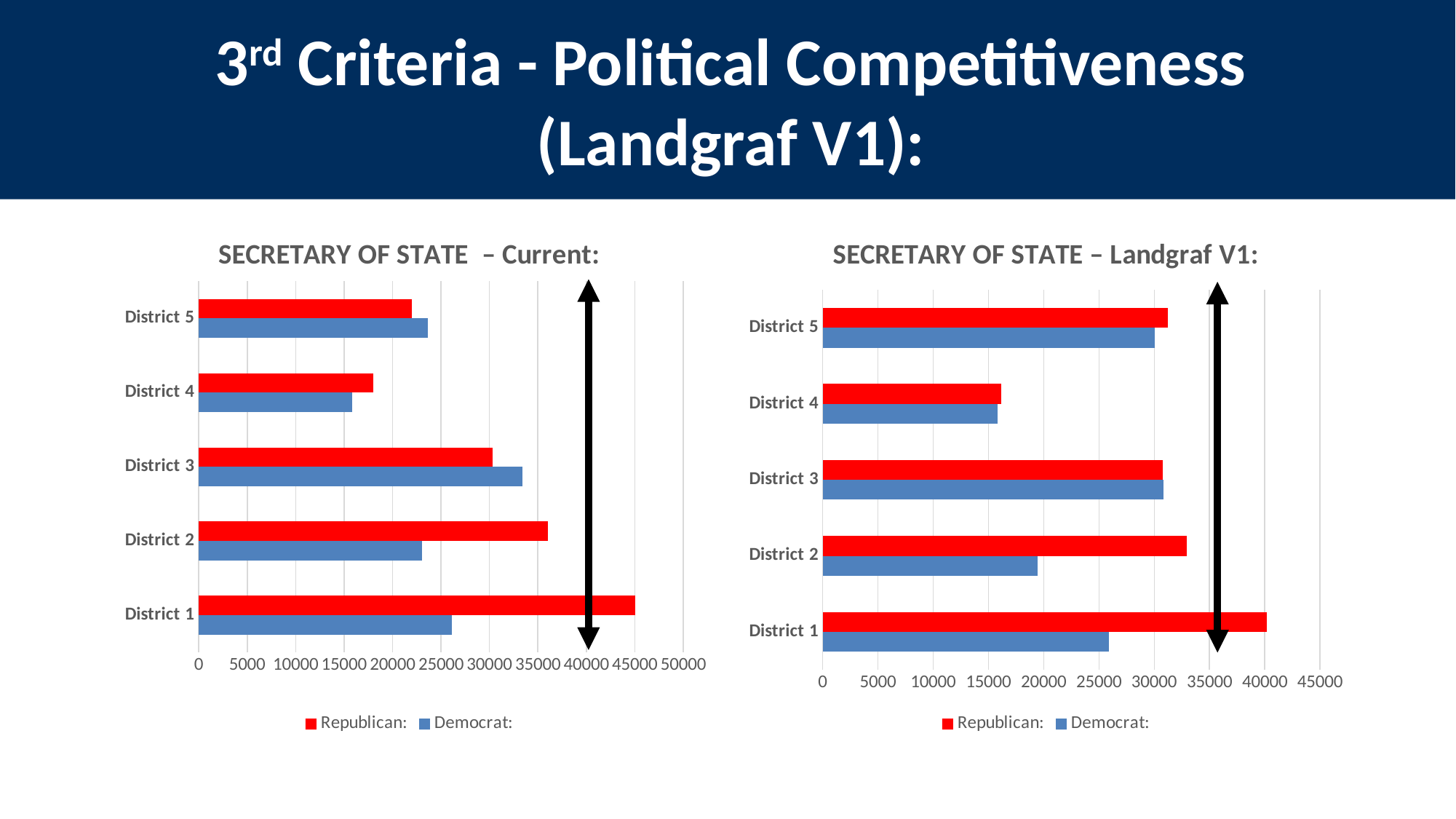
How many series does the legend of the 'SECRETARY OF STATE – Current:' chart list? 2 In the 'SECRETARY OF STATE – Current:' chart, is the Republican or the Democrat value larger for District 3? Democrat What kind of chart is the 'SECRETARY OF STATE – Current:' chart? bar chart In the 'SECRETARY OF STATE – Landgraf V1:' chart, is the Democrat value for District 2 greater or less than 25000? less In the 'SECRETARY OF STATE – Landgraf V1:' chart, is the Republican value for District 1 greater or less than 35000? greater In the 'SECRETARY OF STATE – Current:' chart, which colour represents the Democrat series? blue How many districts are shown on the 'SECRETARY OF STATE – Landgraf V1:' chart? 5 In the 'SECRETARY OF STATE – Current:' chart, which district has the lowest Democrat value? District 4 In the 'SECRETARY OF STATE – Current:' chart, is the Republican or the Democrat value larger for District 2? Republican In the 'SECRETARY OF STATE – Current:' chart, which district has the highest Republican value? District 1 In the 'SECRETARY OF STATE – Landgraf V1:' chart, which district has the highest Republican value? District 1 In the 'SECRETARY OF STATE – Landgraf V1:' chart, which district has the lowest Republican value? District 4